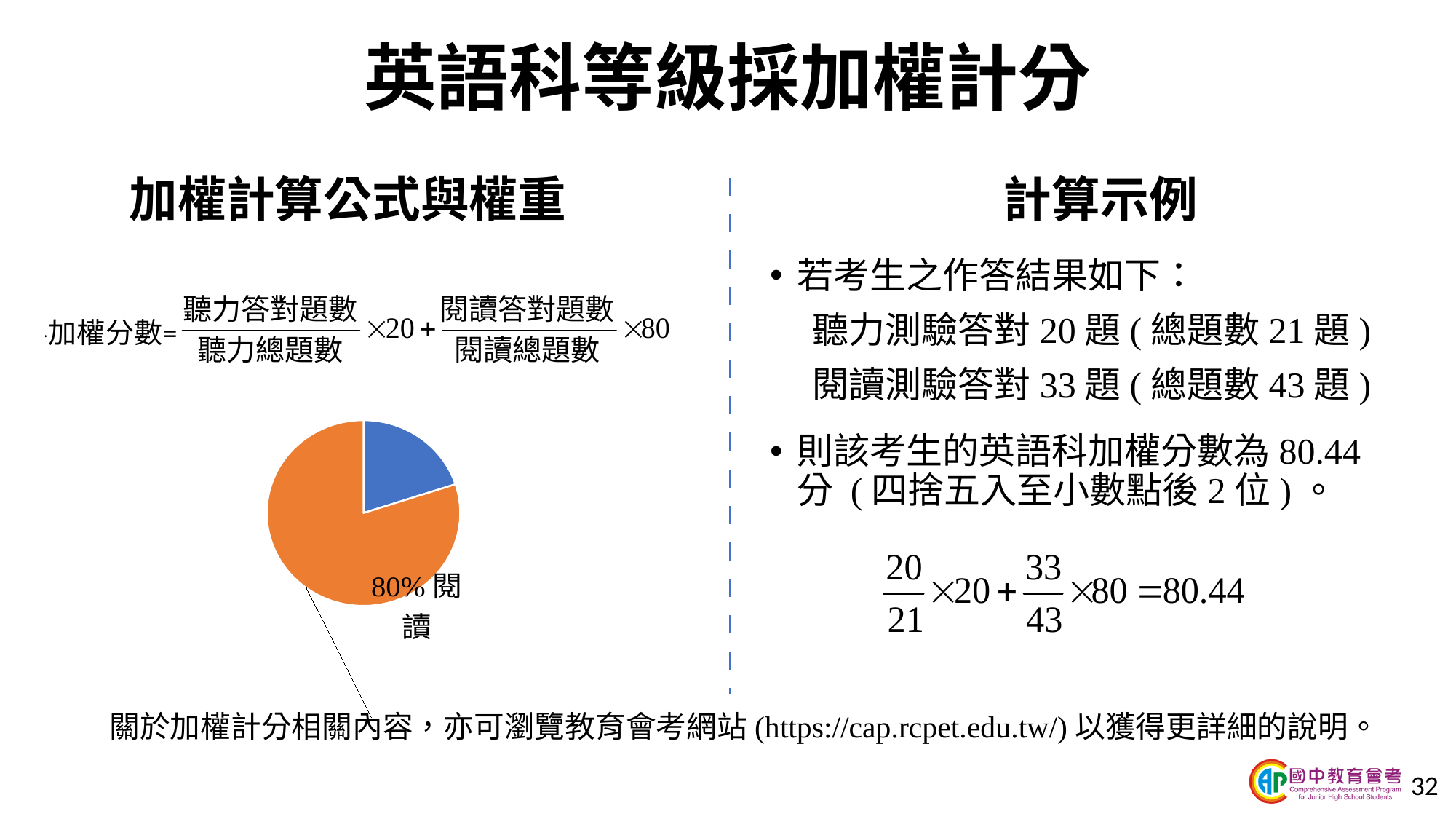
Which slice is larger, the orange slice or the blue slice? the orange slice What label is printed next to the orange slice of the pie chart? 80% 閱讀 Which slice of the pie chart is the largest? 閱讀 What share of the pie does the 閱讀 slice represent? 80% What kind of chart is shown on the slide? pie chart Which slice of the pie chart is the smallest? the blue slice What colour is the 閱讀 slice of the pie chart? orange How many slices does the pie chart have? 2